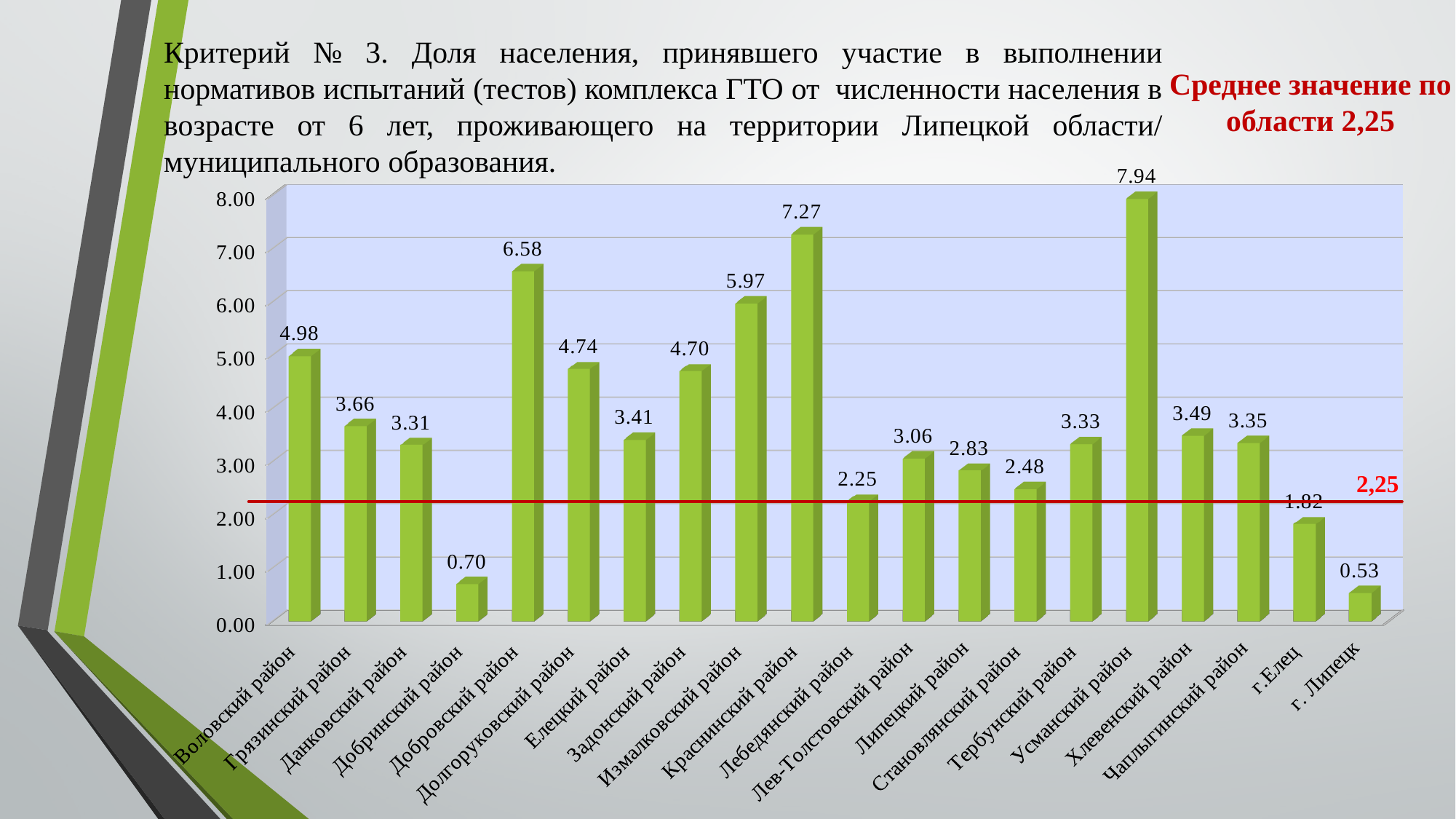
How many categories are shown on the x axis? 20 What is the value for Добринский район? 0.70 What is the difference between the values for Усманский район and г. Липецк? 7.41 What is the difference between the values for Добровский район and Воловский район? 1.60 What kind of chart is shown on the slide? Bar chart What value does the red horizontal line on the chart mark? 2,25 Which category has the lowest value? г. Липецк What is the value for Краснинский район? 7.27 Which category has the highest value? Усманский район Which is larger, the value for Измалковский район or the value for Долгоруковский район? Измалковский район What is the value for Усманский район? 7.94 What is the value for г.Елец? 1.82